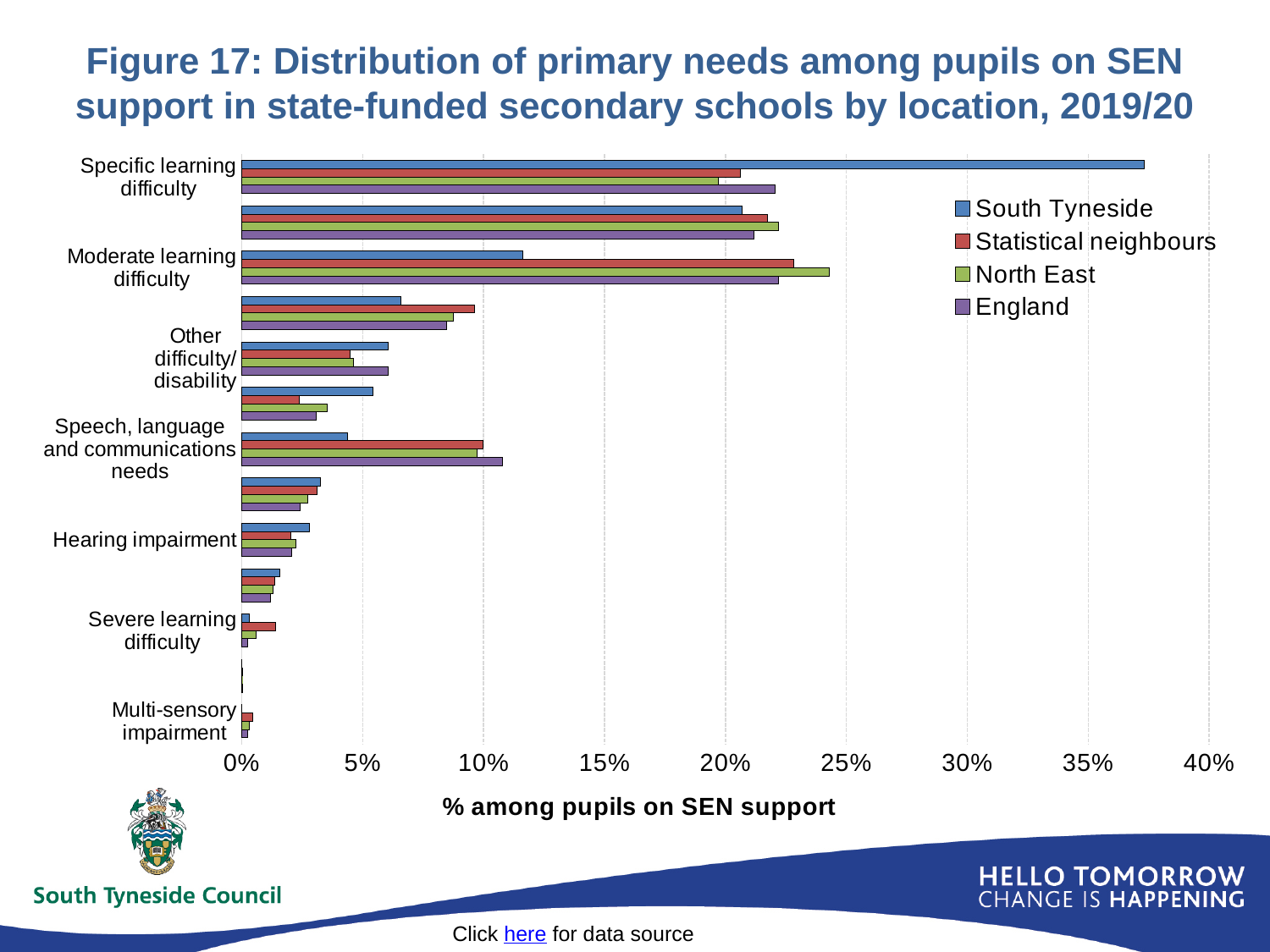
How many series does the legend list? 4 For Specific learning difficulty, which is larger: the South Tyneside value or the England value? South Tyneside Which primary need has the highest South Tyneside value? Specific learning difficulty What kind of chart is shown on the slide? Bar chart For Moderate learning difficulty, which is larger: the South Tyneside value or the North East value? North East Is the England value for Specific learning difficulty greater or less than 20%? greater Is the South Tyneside value for Specific learning difficulty greater or less than 35%? greater What is the title of the horizontal axis? % among pupils on SEN support What are the four series listed in the legend? South Tyneside, Statistical neighbours, North East, England Is the South Tyneside value for Moderate learning difficulty greater or less than 15%? less For Severe learning difficulty, which is larger: the South Tyneside value or the Statistical neighbours value? Statistical neighbours